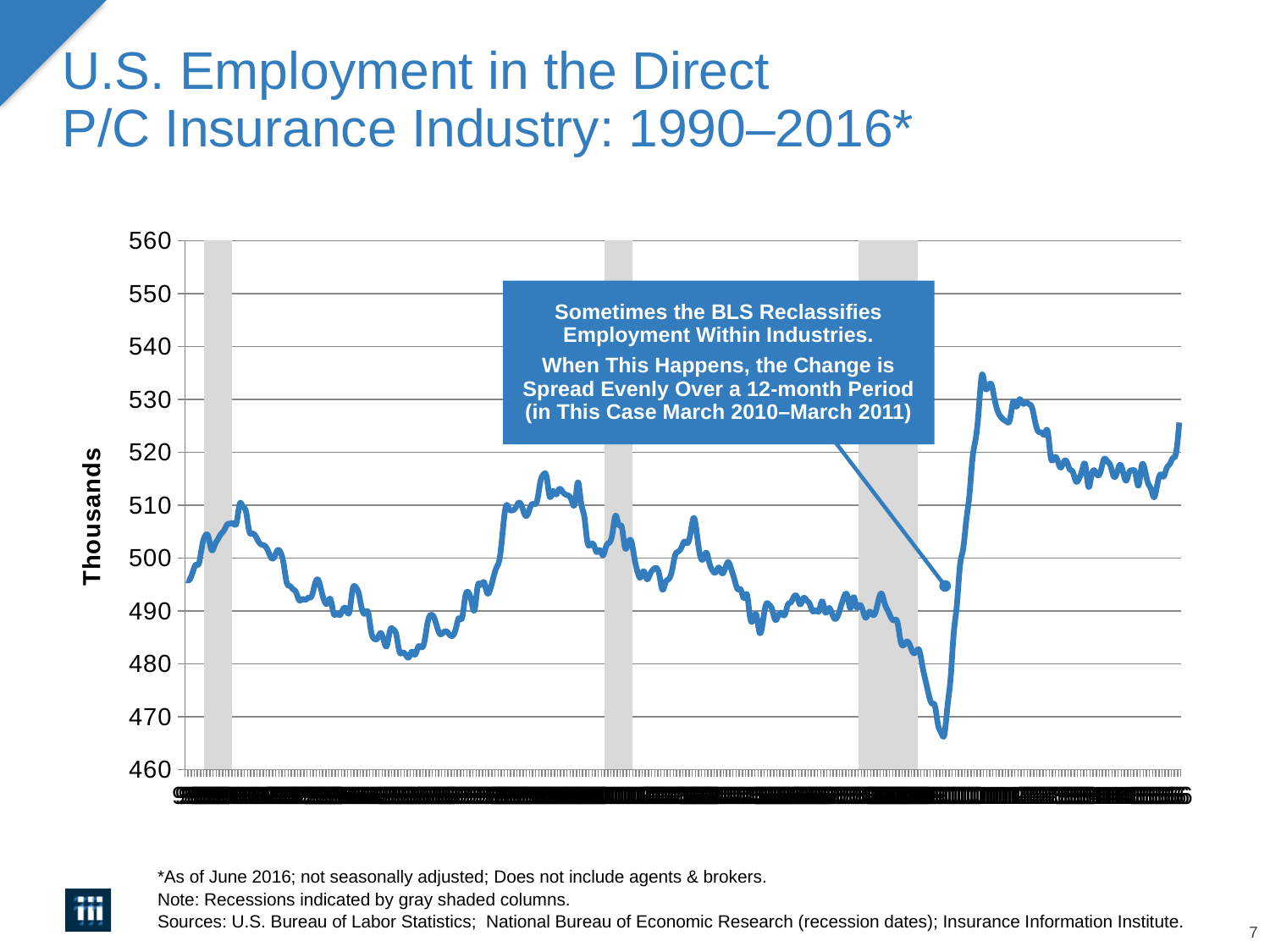
What is the title of the chart on the slide? U.S. Employment in the Direct P/C Insurance Industry: 1990–2016* Is the value of the line at the right edge of the chart larger or smaller than the value at the left edge? larger Is the lowest point of the line on the chart greater or less than 470? less How many data series are plotted on the chart? 1 Is the first value of the line at the left edge of the chart greater or less than 500? less Is the highest point of the line on the chart greater or less than 540? less What is the label on the vertical axis of the chart? Thousands How many gray shaded recession columns are shown on the chart? 3 What is the lowest value shown on the vertical axis of the chart? 460 What kind of chart is shown on the slide? line chart